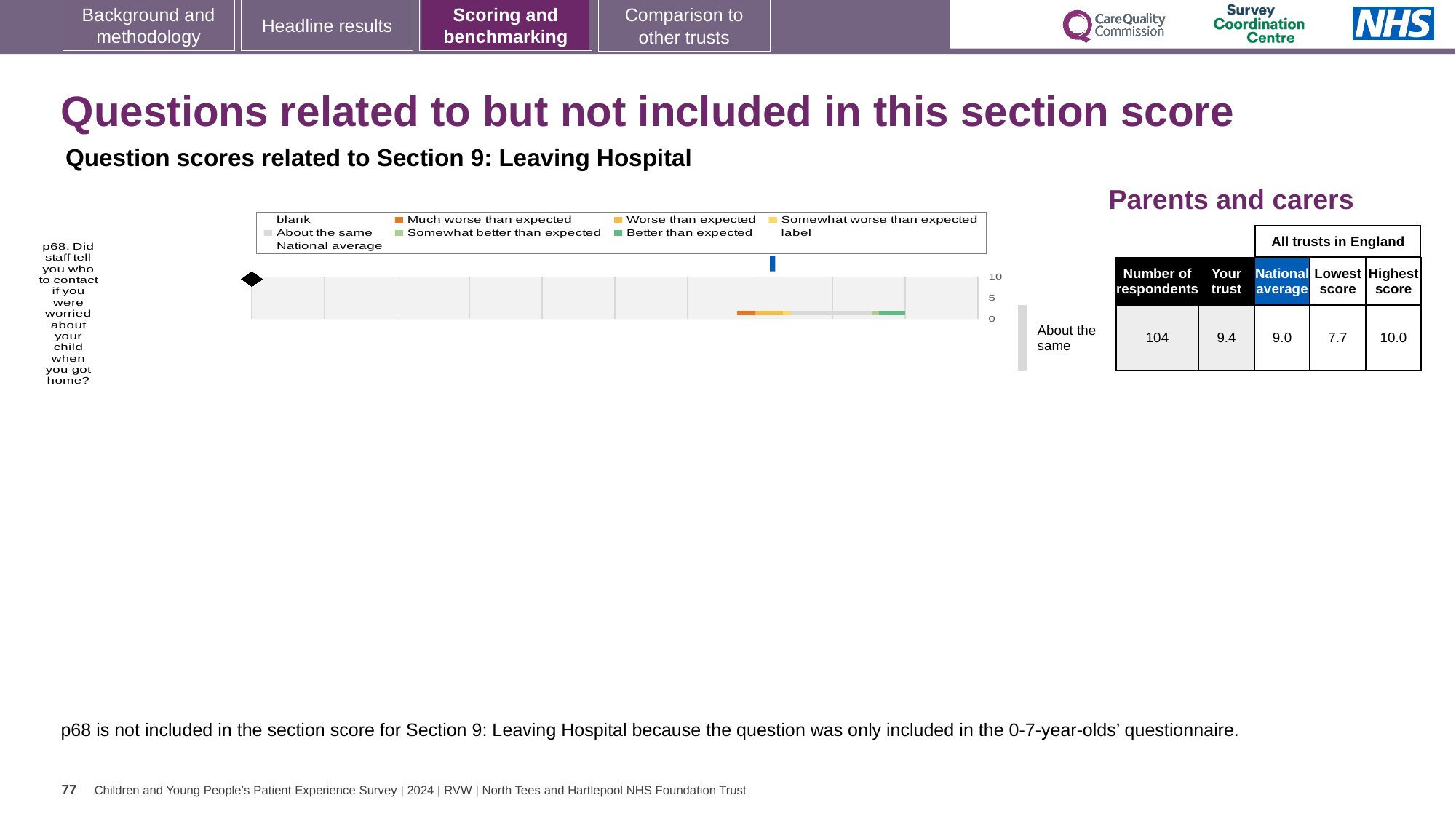
According to the table next to the chart, what is the 'Your trust' score for p68? 9.4 What is the difference between the 'Your trust' score and the national average for p68? 0.4 How many questions are plotted in the chart? 1 Is the 'Your trust' score for p68 higher or lower than the national average? higher How many entries does the legend of the p68 chart list? 9 According to the table next to the chart, what is the national average score for p68? 9.0 According to the table, what is the lowest score among all trusts in England for p68? 7.7 Which legend entry is shown in orange? Much worse than expected What is the highest value shown on the chart's axis? 10 How many respondents answered p68 according to the table? 104 According to the table, what is the highest score among all trusts in England for p68? 10.0 What kind of chart is shown for question p68? bar chart